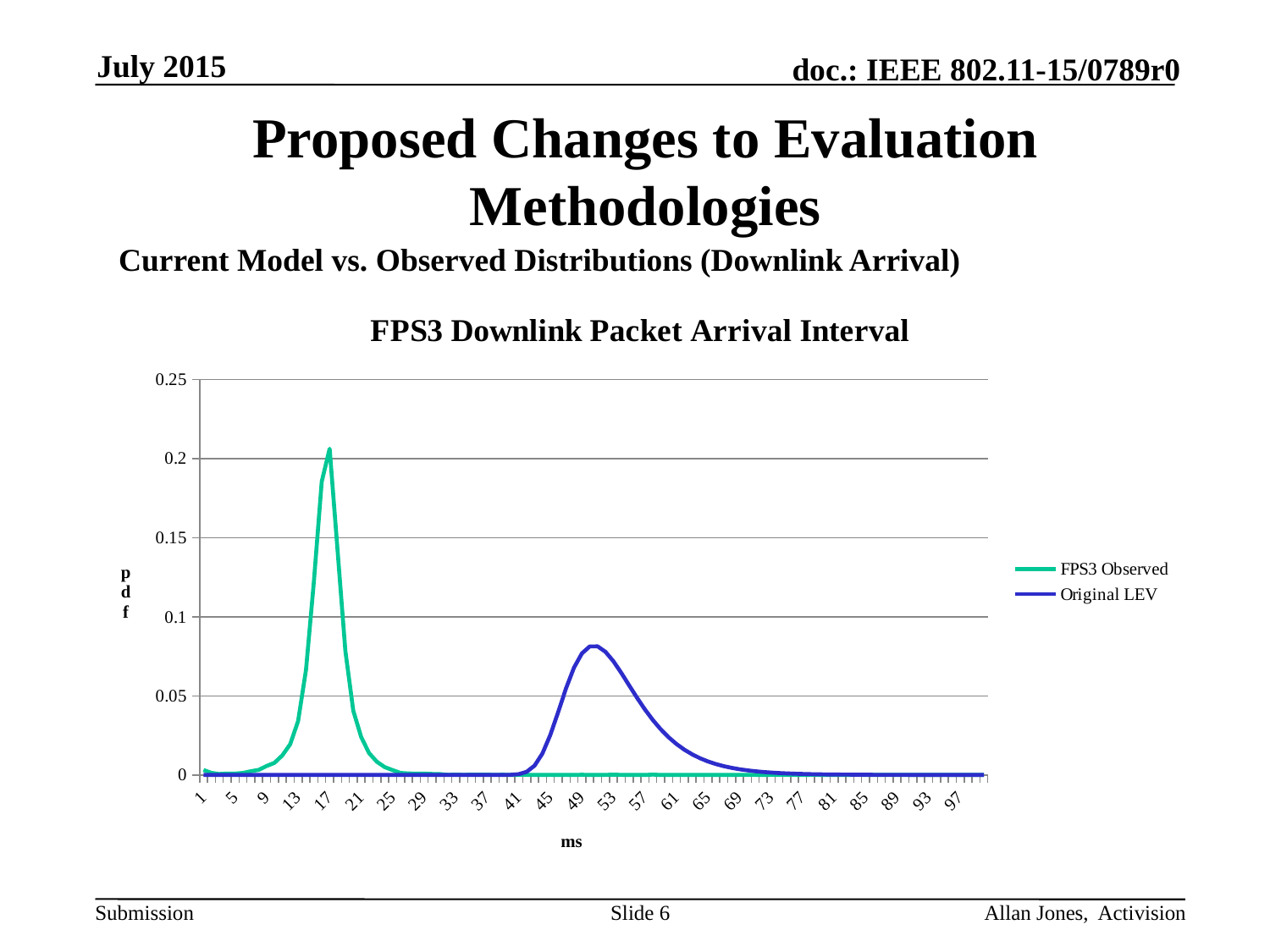
Is the value of the FPS3 Observed series at 33 ms greater or less than 0.05? less What are the two series named in the chart's legend? FPS3 Observed and Original LEV Is the peak value of the FPS3 Observed series greater or less than 0.15? greater Is the peak value of the Original LEV series greater or less than 0.05? greater What is the title of the chart? FPS3 Downlink Packet Arrival Interval What is the highest value shown on the y axis of the chart? 0.25 What kind of chart is shown on the slide? line chart How many series does the chart's legend list? 2 Which series reaches the higher peak value, FPS3 Observed or Original LEV? FPS3 Observed Which series has its peak at a larger ms value, FPS3 Observed or Original LEV? Original LEV